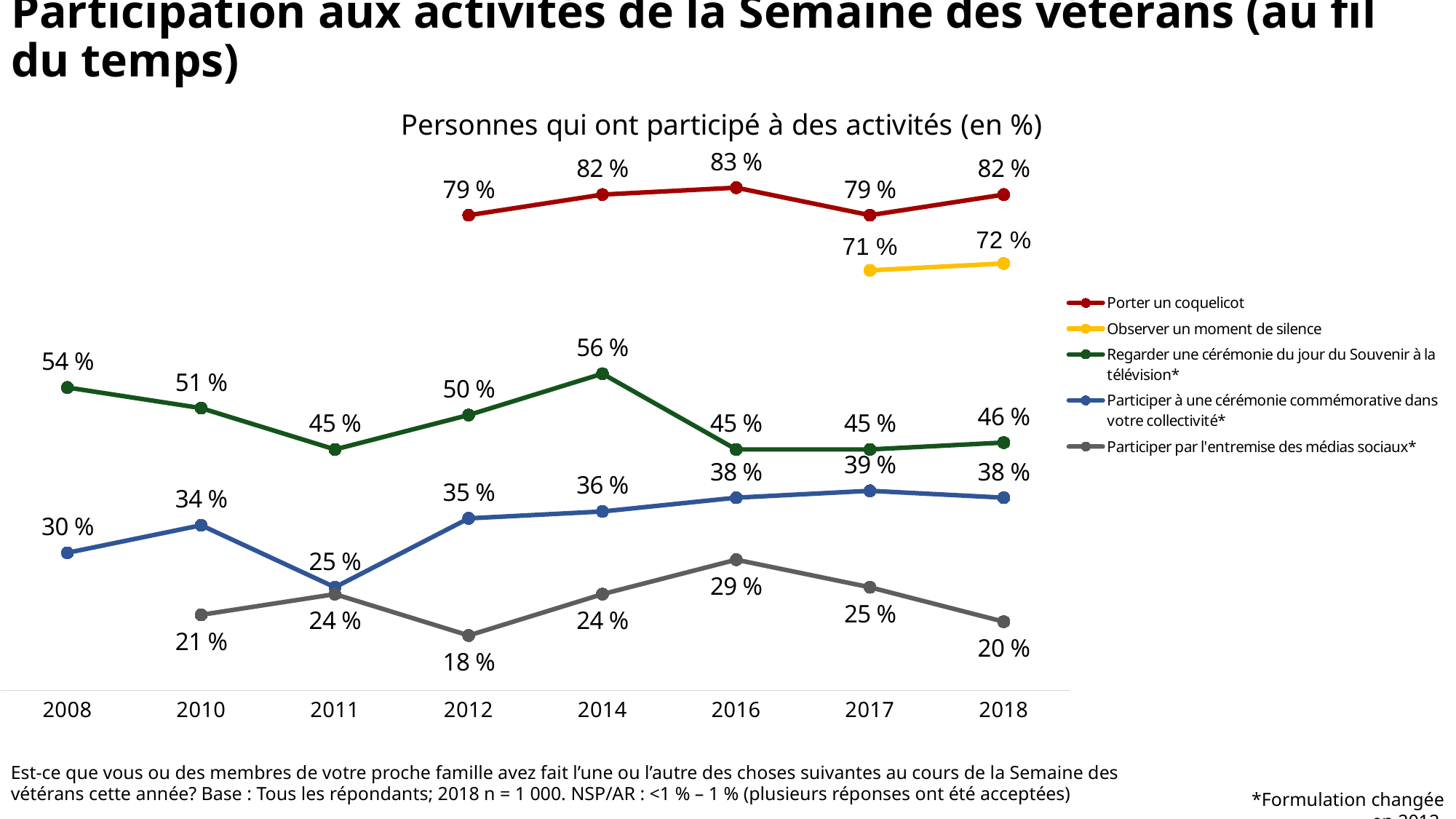
Which series is shown in yellow in the legend? Observer un moment de silence In which year is the value for "Regarder une cérémonie du jour du Souvenir à la télévision*" highest? 2014 What kind of chart is shown on the slide? line chart In which year is the value for "Participer à une cérémonie commémorative dans votre collectivité*" lowest? 2011 How many years are shown on the x axis? 8 What is the value for "Porter un coquelicot" in 2016? 83 % What is the difference between the 2014 and 2016 values for "Regarder une cérémonie du jour du Souvenir à la télévision*"? 11 % Does the value for "Participer par l'entremise des médias sociaux*" rise or fall from 2016 to 2018? fall How many series does the legend list? 5 What is the value for "Observer un moment de silence" in 2018? 72 % Which is larger in 2010: "Participer à une cérémonie commémorative dans votre collectivité*" or "Participer par l'entremise des médias sociaux*"? Participer à une cérémonie commémorative dans votre collectivité* What is the value for "Participer par l'entremise des médias sociaux*" in 2012? 18 %